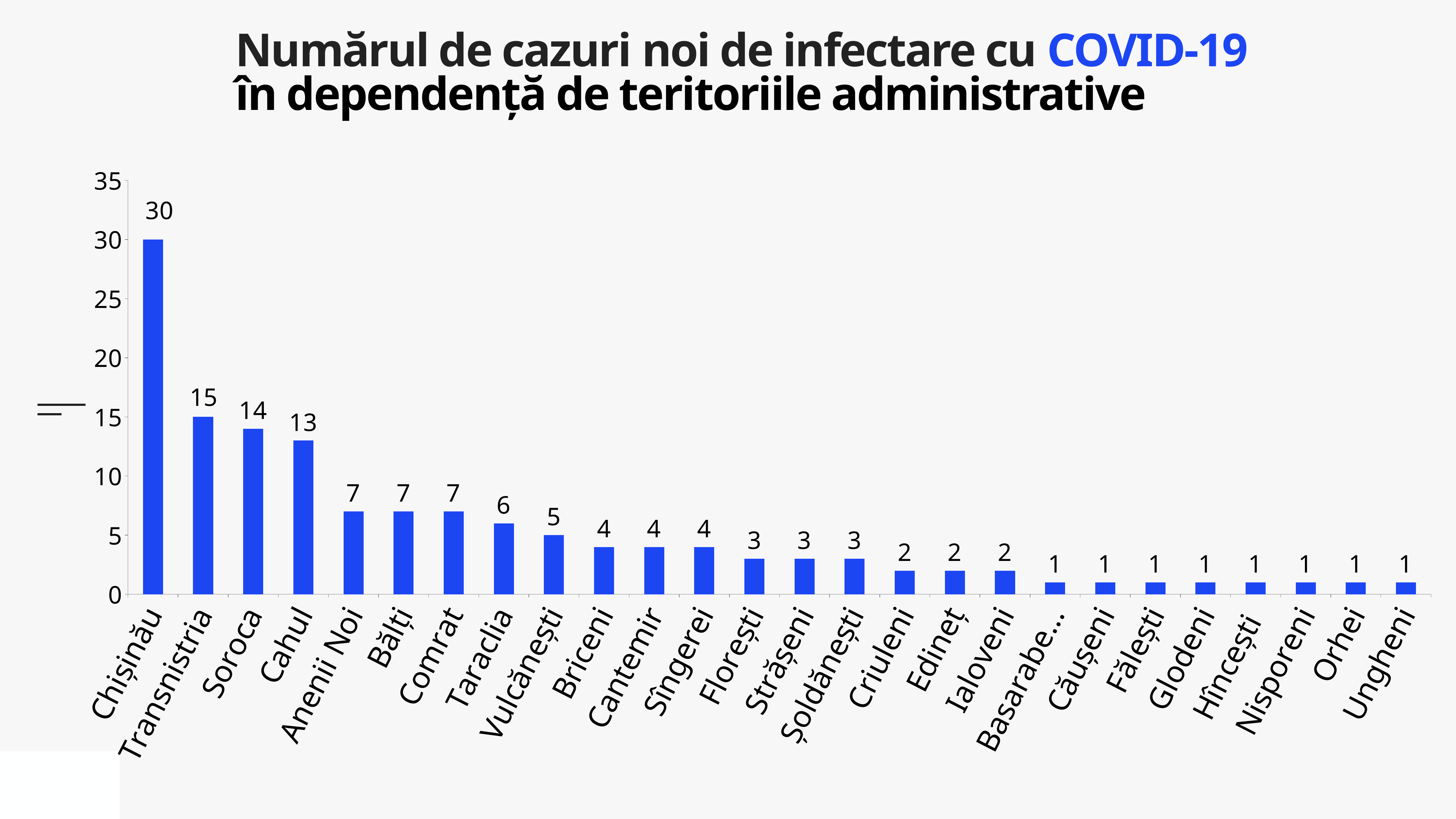
What is the number of new COVID-19 cases for Chișinău? 30 Which has more new cases, Vulcănești or Briceni? Vulcănești Do the values rise or fall from left to right along the x axis? Fall What is the difference in new cases between Chișinău and Transnistria? 15 What is the number of new cases for Taraclia? 6 Which has more new cases, Soroca or Cahul? Soroca Which territory has the highest number of new cases? Chișinău What is the number of new cases for Criuleni? 2 What type of chart is shown on the slide? Bar chart How many territories are shown on the chart? 26 What is the number of new cases for Soroca? 14 What is the difference in new cases between Cahul and Anenii Noi? 6